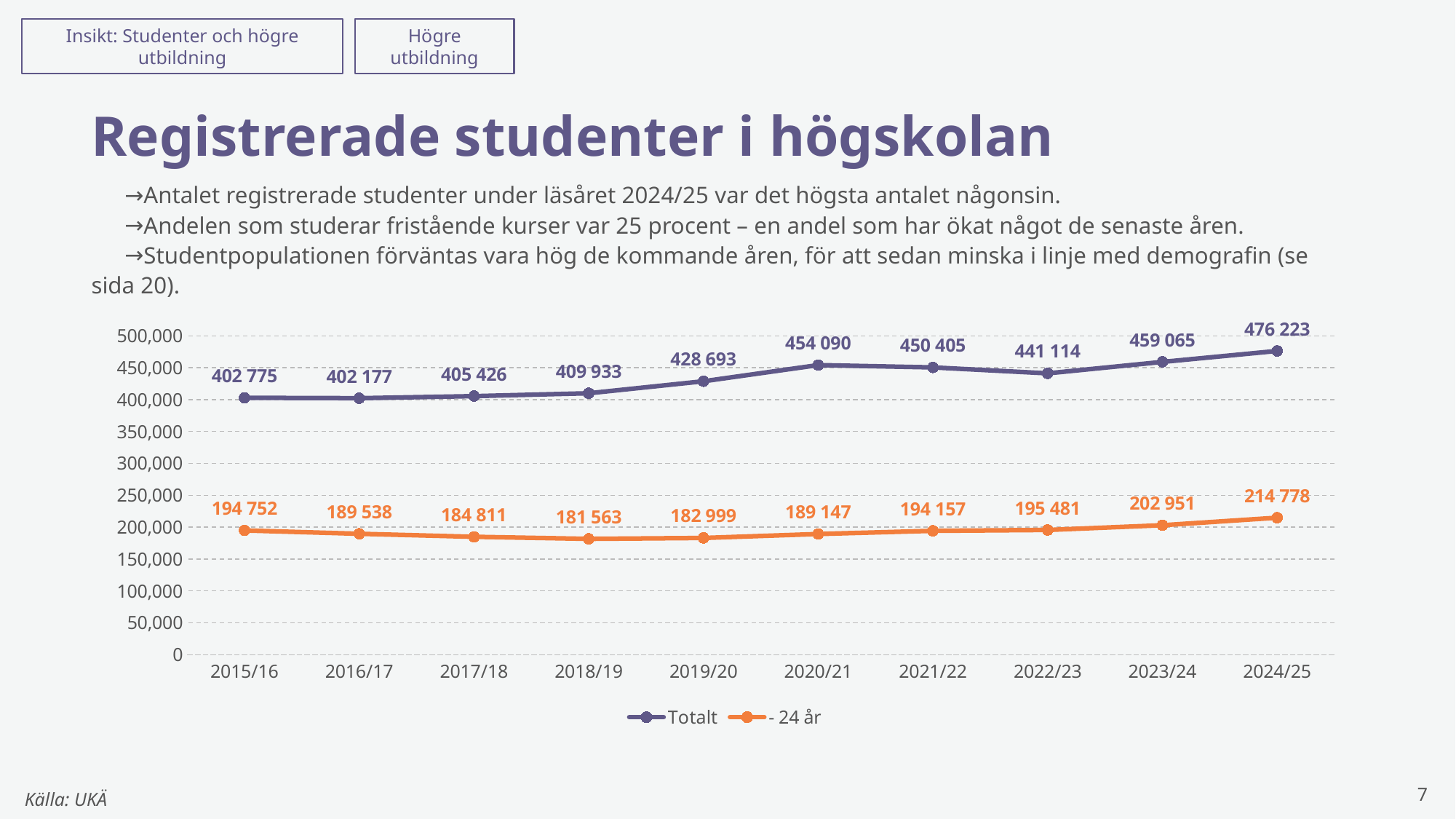
What is the difference between the Totalt and - 24 år values in 2024/25? 261 445 In which academic year is the - 24 år series at its highest? 2024/25 In which academic year is the Totalt series at its lowest? 2016/17 Which is larger for the Totalt series: the value for 2021/22 or the value for 2022/23? 2021/22 What is the value of the Totalt series for 2020/21? 454 090 In which academic year is the - 24 år series at its lowest? 2018/19 What is the difference between the Totalt values for 2024/25 and 2015/16? 73 448 How many academic years are shown on the x axis? 10 What kind of chart is shown on the slide? Line chart How many series does the legend list? 2 What is the value of the - 24 år series for 2018/19? 181 563 What is the value of the Totalt series for 2024/25? 476 223